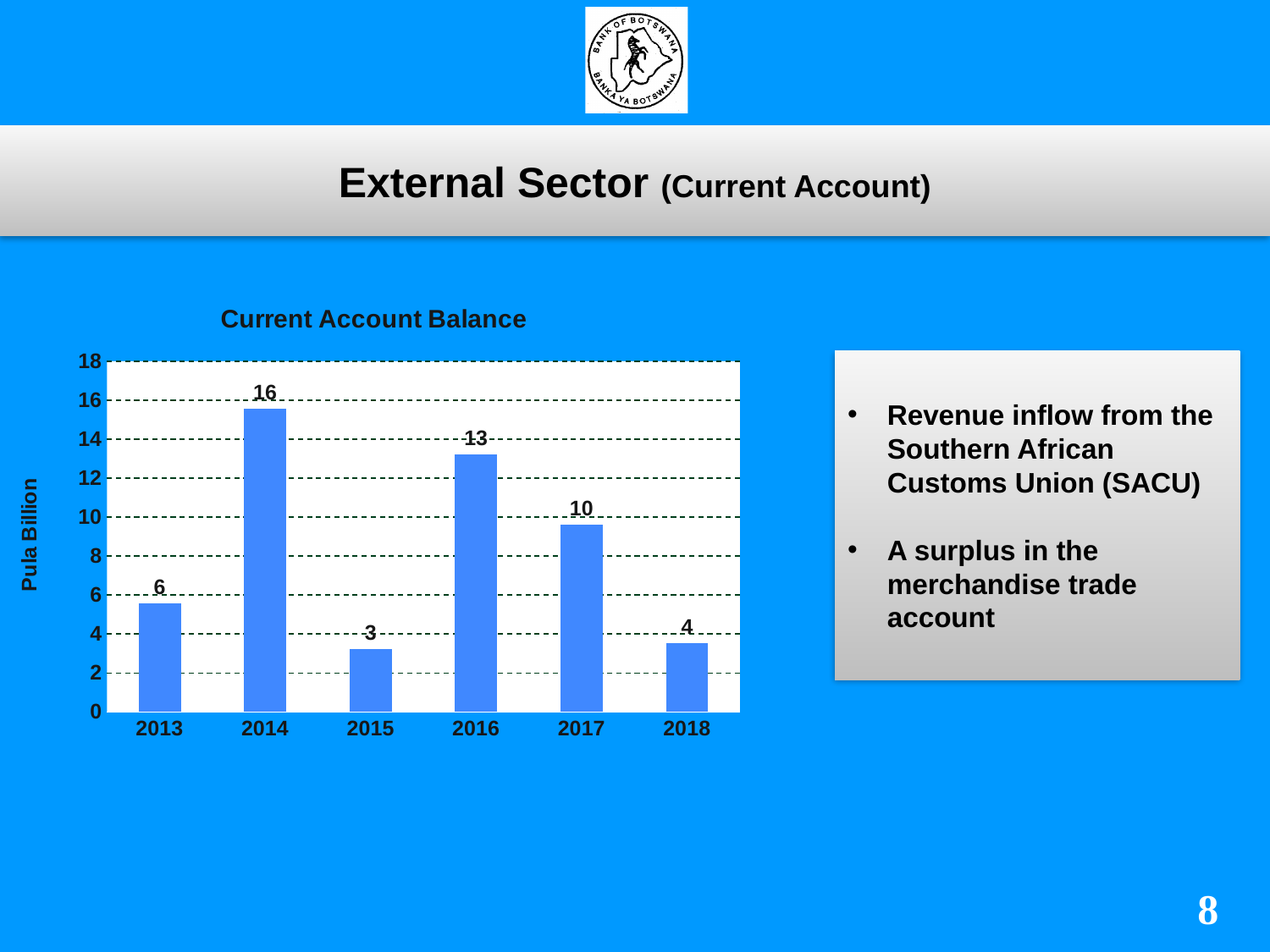
Which year has the lowest Current Account Balance? 2015 Is the Current Account Balance for 2013 greater or less than 8? less Does the Current Account Balance rise or fall from 2016 to 2018? fall What is the Current Account Balance for 2015? 3 What is the Current Account Balance for 2017? 10 Which year has a larger Current Account Balance, 2016 or 2017? 2016 What kind of chart is the Current Account Balance chart? bar chart What is the Current Account Balance for 2014? 16 What is the label on the vertical axis of the Current Account Balance chart? Pula Billion How many years are shown on the Current Account Balance chart? 6 Which year has the highest Current Account Balance? 2014 What is the difference between the Current Account Balance in 2014 and 2018? 12